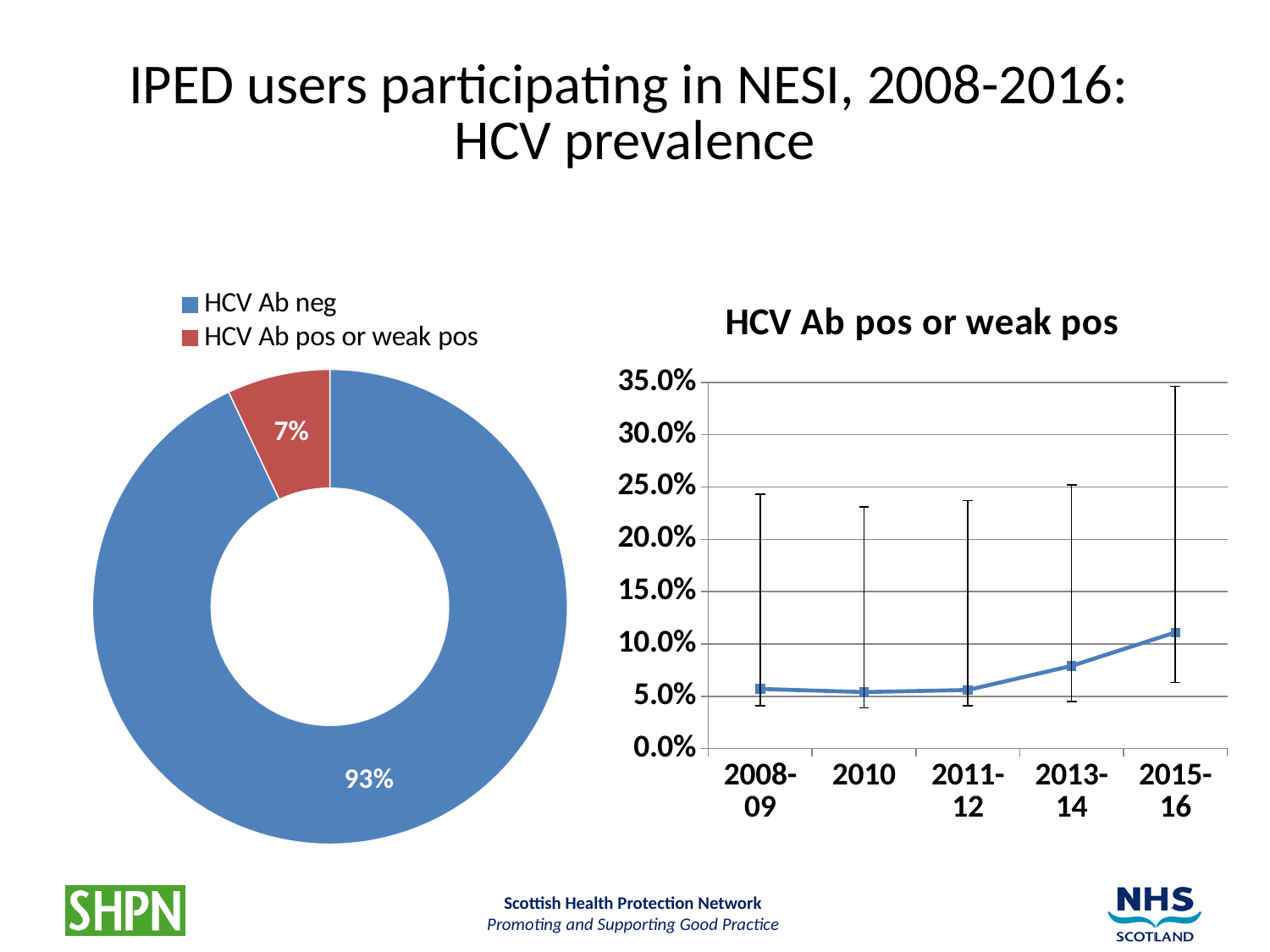
In the 'HCV Ab pos or weak pos' chart, which time period has the highest value? 2015-16 In the doughnut chart on the left, which category is larger: HCV Ab neg or HCV Ab pos or weak pos? HCV Ab neg What kind of chart is the chart on the left of the slide? Doughnut chart How many time periods are plotted on the x axis of the 'HCV Ab pos or weak pos' chart? 5 How many entries does the legend of the doughnut chart on the left list? 2 In the doughnut chart on the left, what is the difference in percentage points between HCV Ab neg and HCV Ab pos or weak pos? 86 percentage points In the 'HCV Ab pos or weak pos' chart, is the value for 2015-16 greater or less than 10.0%? greater What kind of chart is the 'HCV Ab pos or weak pos' chart on the right? Line chart In the 'HCV Ab pos or weak pos' chart, does the plotted value rise or fall between 2011-12 and 2015-16? Rise In the doughnut chart on the left, what percentage of IPED users are HCV Ab neg? 93% In the 'HCV Ab pos or weak pos' chart, is the value for 2008-09 greater or less than 10.0%? less In the doughnut chart on the left, what percentage of IPED users are HCV Ab pos or weak pos? 7%